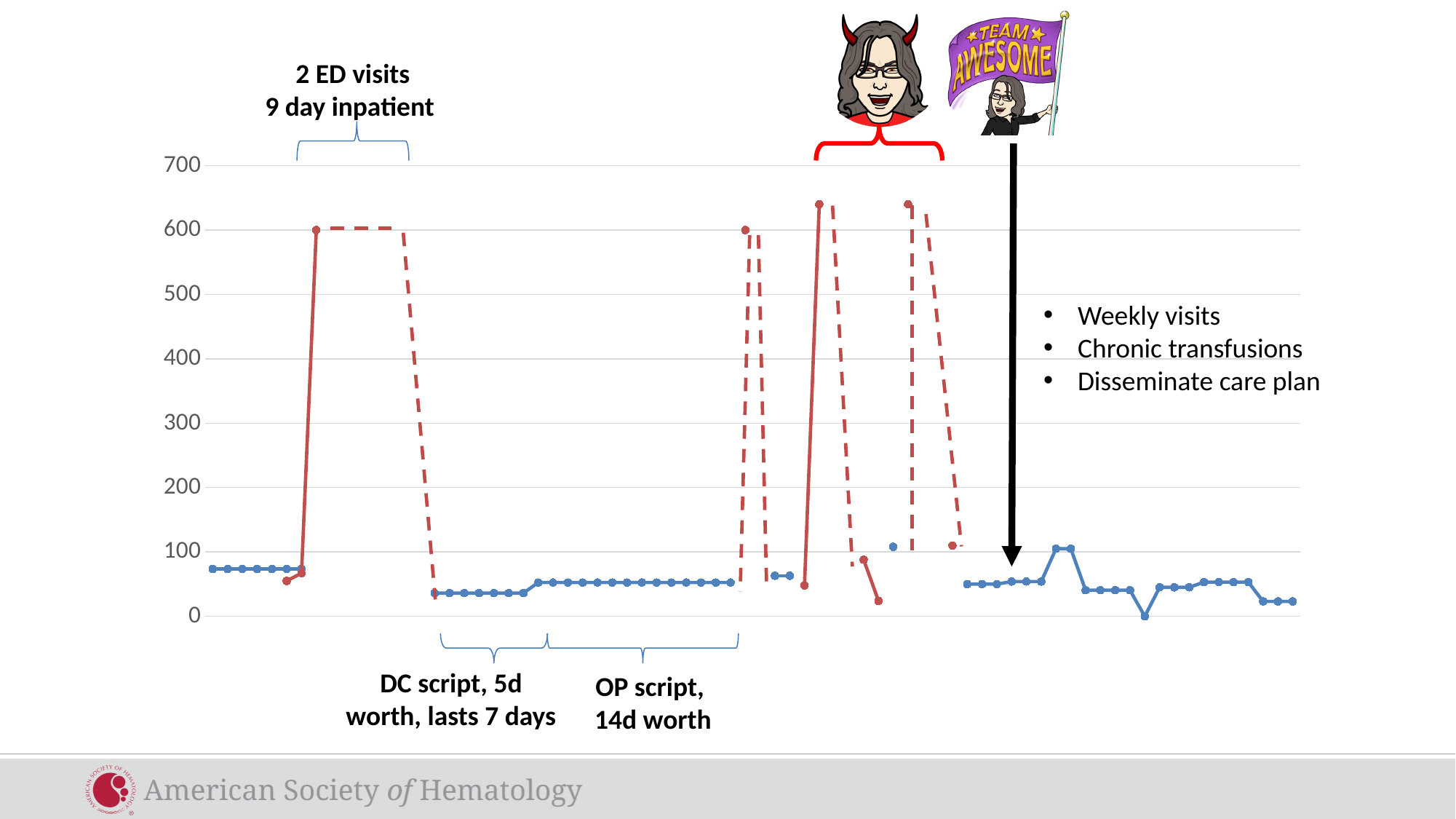
What three bullet points are listed next to the black arrow? Weekly visits; Chronic transfusions; Disseminate care plan Is the first plateau at 600 higher or lower than the tallest red spikes under the red bracket? lower Are the two tallest red spikes under the red bracket greater or less than 600? greater What is the highest tick shown on the y axis? 700 What kind of chart is shown on the slide? line chart Are the blue values after the black arrow greater or less than 200? less Are the leftmost blue points at the start of the chart greater or less than 100? less What is the lowest value reached by the blue line after the black arrow? 0 What value does the first plateau under the "2 ED visits / 9 day inpatient" bracket reach on the y axis? 600